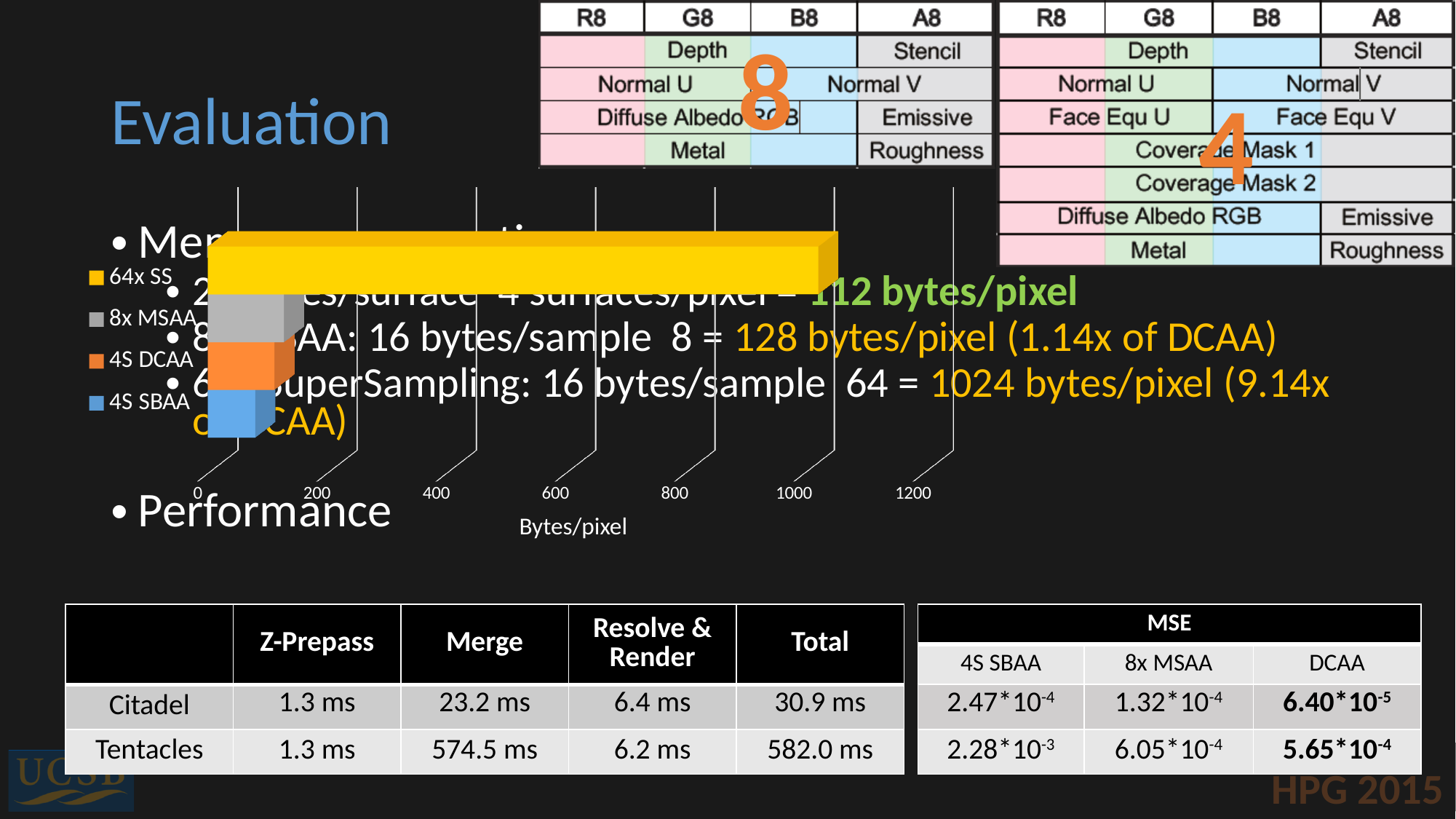
What is the highest tick value shown on the chart's horizontal axis? 1200 How many entries does the chart legend list? 4 What kind of chart is shown on the slide? bar chart What is the label of the horizontal axis of the chart? Bytes/pixel Is the value for 4S DCAA greater or less than 400 bytes/pixel? less How many bars are plotted in the chart? 4 Which legend entry has the shortest bar in the chart? 4S SBAA Is the value for 64x SS greater or less than 800 bytes/pixel? greater Which legend entry has the longest bar in the chart? 64x SS Is the value for 4S SBAA greater or less than 200 bytes/pixel? less Which is larger in the chart, the value for 64x SS or the value for 8x MSAA? 64x SS